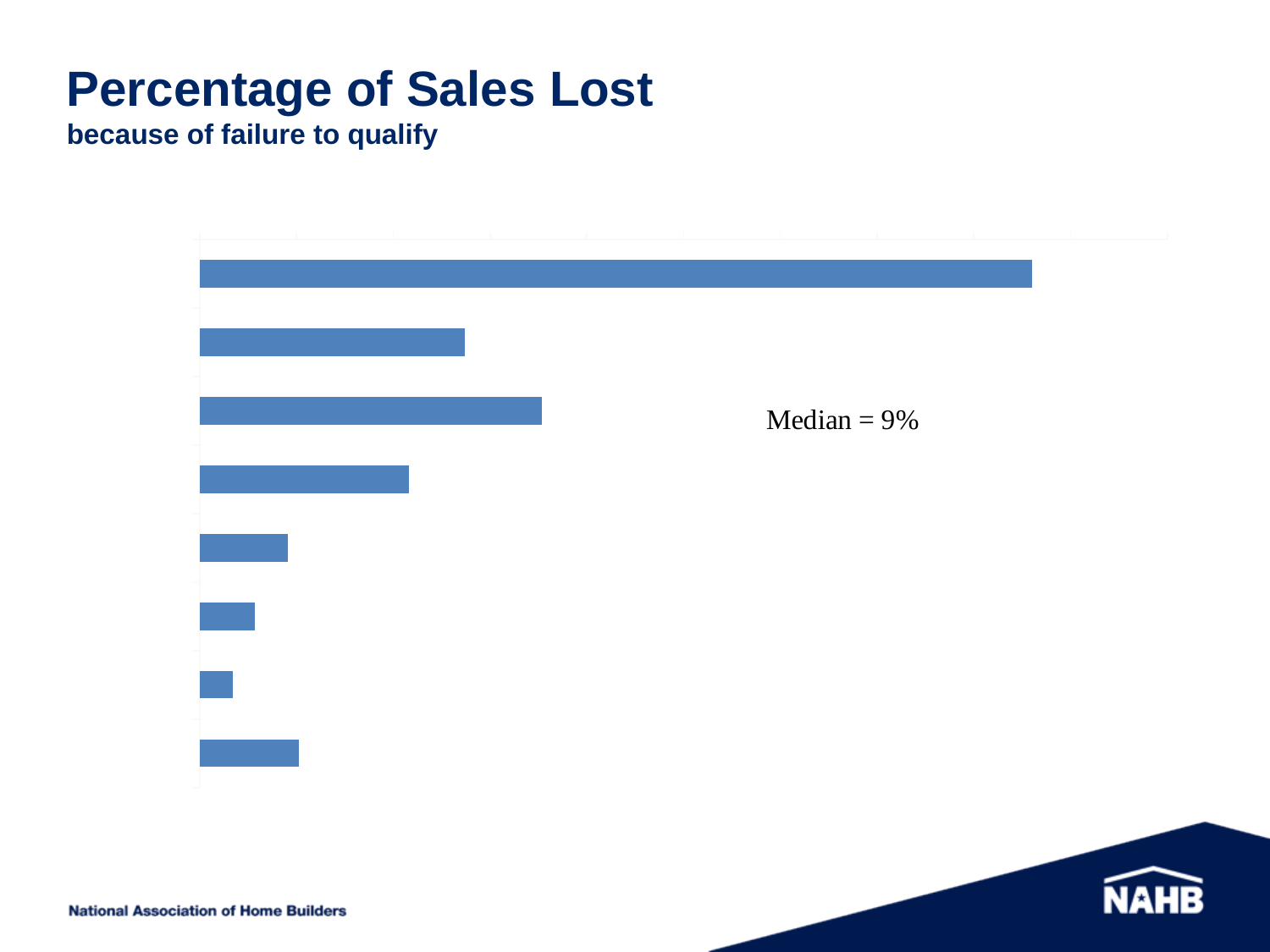
Which is longer, the top bar or the third bar from the top? the top bar Which bar is the longest in the chart? the top bar Which is longer, the second bar from the top or the third bar from the top? the third bar from the top Which is longer, the sixth bar from the top or the bottom bar? the bottom bar What is the title of the slide's chart? Percentage of Sales Lost because of failure to qualify What median value is annotated on the chart? 9% How many bars does the chart contain? 8 Which bar is the shortest in the chart? the seventh bar from the top What kind of chart is shown on the slide? bar chart